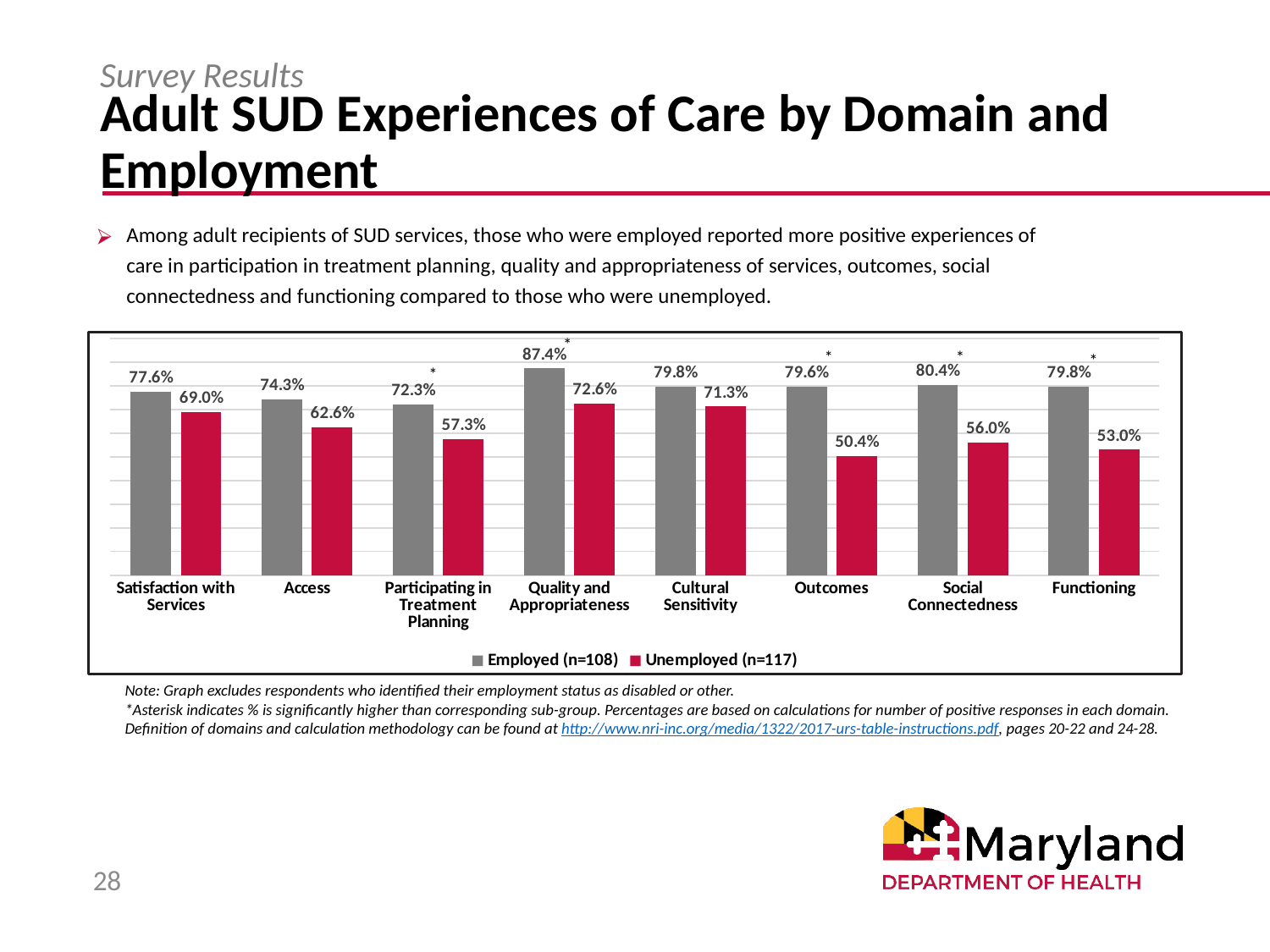
What kind of chart is shown on the slide? Bar chart What is the value for Employed (n=108) in the Outcomes domain? 79.6% What is the difference between the Employed (n=108) and Unemployed (n=117) values for Outcomes? 29.2% What is the value for Unemployed (n=117) in the Access domain? 62.6% What colour are the bars for the Unemployed (n=117) series? Red What is the value for Unemployed (n=117) in the Social Connectedness domain? 56.0% What is the difference between the Employed (n=108) and Unemployed (n=117) values for Satisfaction with Services? 8.6% Which is larger: the Unemployed (n=117) value for Quality and Appropriateness or the Unemployed (n=117) value for Cultural Sensitivity? Quality and Appropriateness Which domain has the highest value for Employed (n=108)? Quality and Appropriateness Which domain has the lowest value for Unemployed (n=117)? Outcomes How many series does the legend list? 2 How many domains are shown on the x axis of the chart? 8